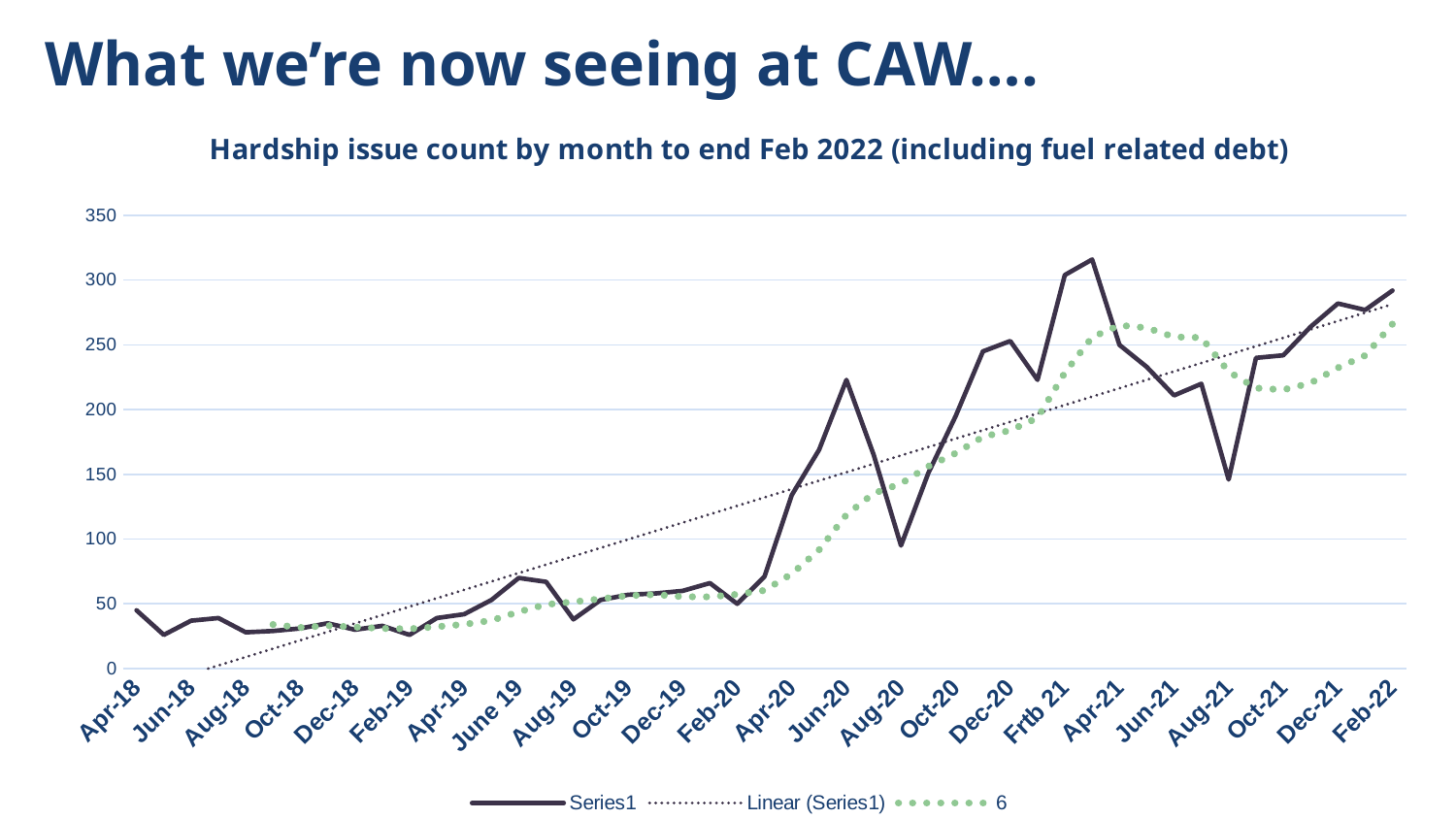
What is the title of the chart? Hardship issue count by month to end Feb 2022 (including fuel related debt) Is the Series1 value for Aug-21 greater or less than 200? less Is the Series1 value for Feb-22 greater or less than 250? greater Is the Series1 value for Aug-20 greater or less than 150? less What kind of chart is shown on the slide? line chart What is the highest value shown on the vertical axis? 350 Overall, do the Series1 values rise or fall from Apr-18 to Feb-22? rise How many entries does the chart legend list? 3 Which has the larger Series1 value, Jun-20 or Aug-20? Jun-20 Which has the larger Series1 value, Apr-18 or Feb-22? Feb-22